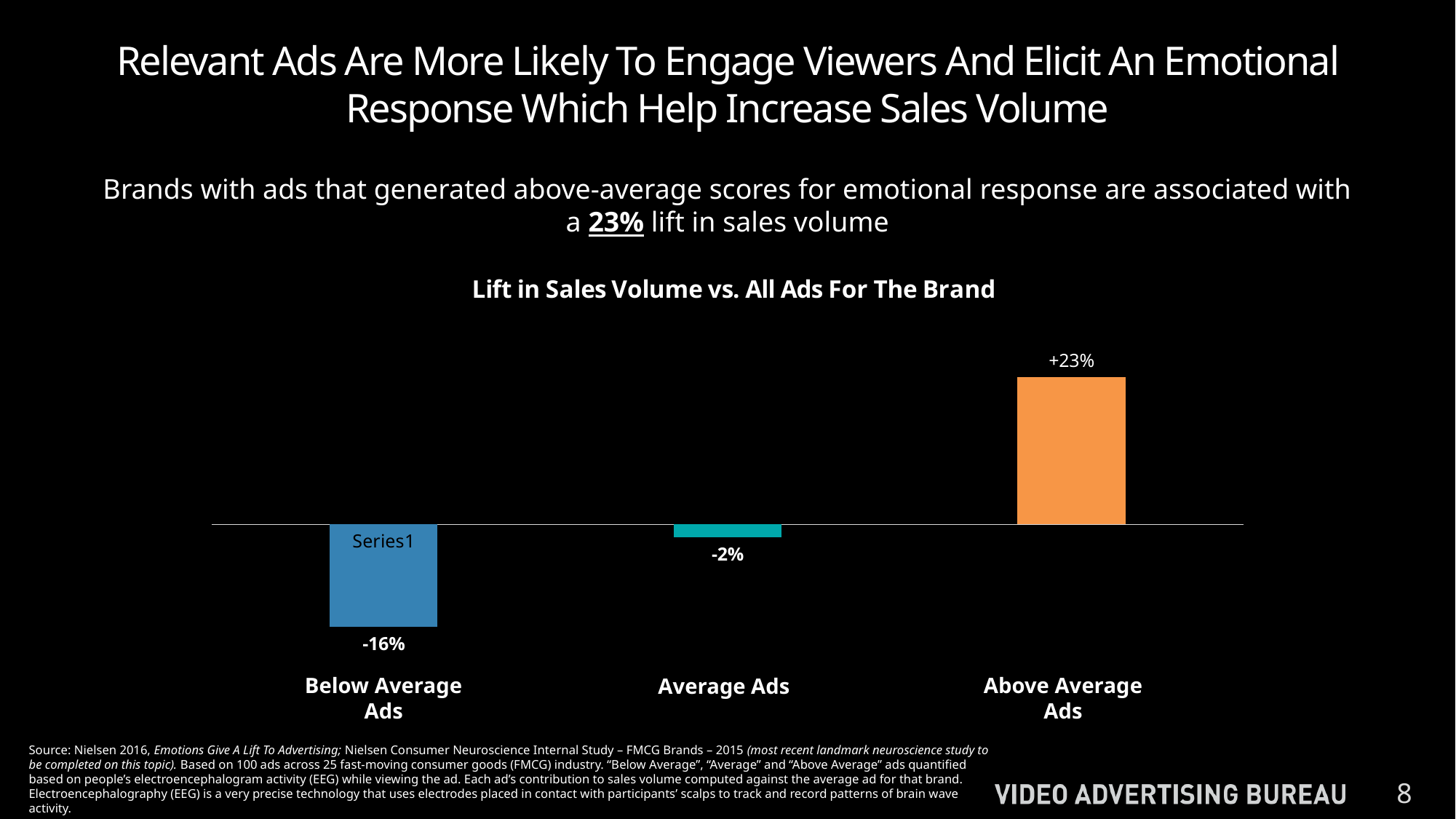
How many categories are shown in the chart? 3 What is the difference in percentage points between the lift for Average Ads and Below Average Ads? 14 percentage points What is the title of the chart? Lift in Sales Volume vs. All Ads For The Brand What kind of chart is shown on the slide? Bar chart What is the lift in sales volume for Below Average Ads? -16% Do the values rise or fall moving from Below Average Ads to Above Average Ads? Rise Which is larger, the lift for Average Ads or Below Average Ads? Average Ads What is the difference in percentage points between the lift for Above Average Ads and Below Average Ads? 39 percentage points What is the lift in sales volume for Above Average Ads? +23% Which category has the highest lift in sales volume? Above Average Ads Which category has the lowest lift in sales volume? Below Average Ads What is the lift in sales volume for Average Ads? -2%